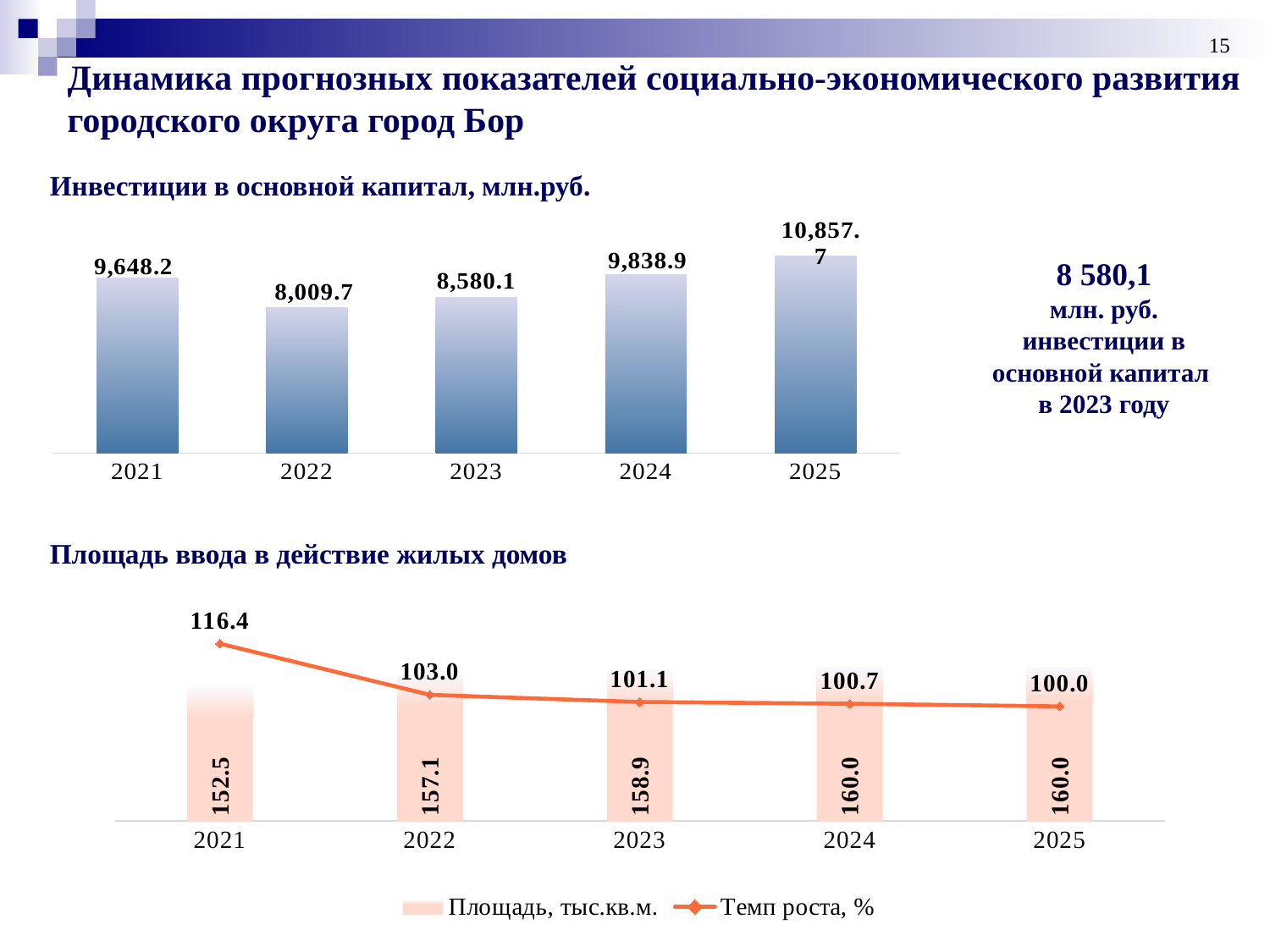
In the chart 'Инвестиции в основной капитал, млн.руб.', how many years are shown on the x axis? 5 In the chart 'Площадь ввода в действие жилых домов', what is the difference between 'Темп роста, %' for 2021 and 2022? 13.4 In the chart 'Инвестиции в основной капитал, млн.руб.', what is the value for 2022? 8,009.7 In the chart 'Площадь ввода в действие жилых домов', which is larger: 'Площадь, тыс.кв.м.' for 2021 or for 2022? 2022 What kind of chart is 'Инвестиции в основной капитал, млн.руб.'? Bar chart In the chart 'Инвестиции в основной капитал, млн.руб.', which year has the highest value? 2025 In the chart 'Площадь ввода в действие жилых домов', what is the value of 'Площадь, тыс.кв.м.' for 2023? 158.9 In the chart 'Инвестиции в основной капитал, млн.руб.', what is the difference between the values for 2025 and 2024? 1,018.8 In the chart 'Инвестиции в основной капитал, млн.руб.', which year has the lowest value? 2022 In the chart 'Площадь ввода в действие жилых домов', how many series does the legend list? 2 In the chart 'Площадь ввода в действие жилых домов', does 'Темп роста, %' rise or fall from 2021 to 2025? Fall In the chart 'Площадь ввода в действие жилых домов', what is the value of 'Темп роста, %' for 2021? 116.4